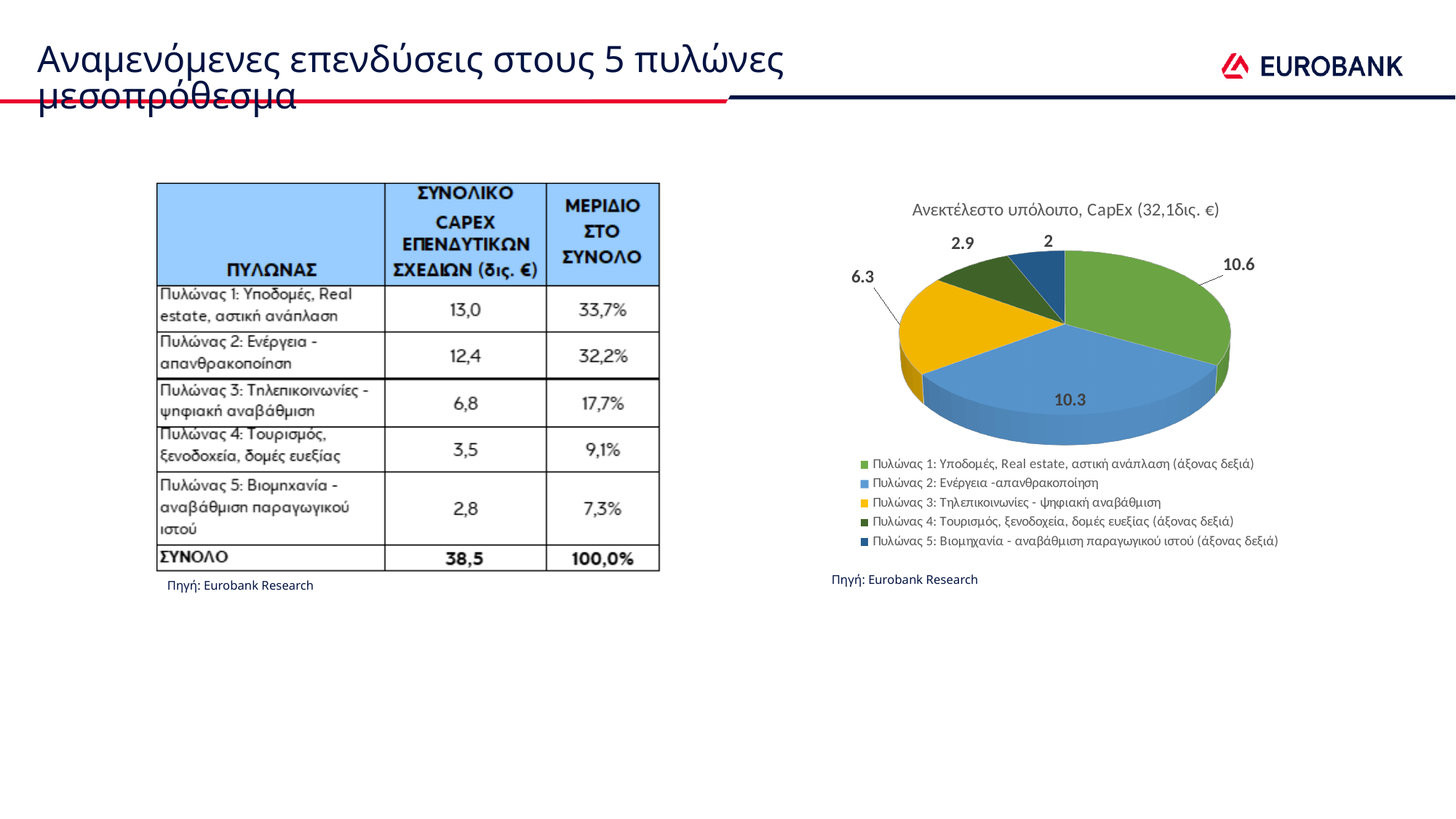
In the pie chart, what is the value for Πυλώνας 2: Ενέργεια - απανθρακοποίηση? 10.3 In the pie chart, which is larger: the value for Πυλώνας 3 or the value for Πυλώνας 4? Πυλώνας 3 How many slices does the pie chart have? 5 In the pie chart, what is the difference between the values for Πυλώνας 1 and Πυλώνας 2? 0.3 In the pie chart, what is the value for Πυλώνας 3: Τηλεπικοινωνίες - ψηφιακή αναβάθμιση? 6.3 How many entries does the legend of the pie chart list? 5 In the pie chart, what is the value for Πυλώνας 5: Βιομηχανία - αναβάθμιση παραγωγικού ιστού? 2 Which slice of the pie chart has the smallest value? Πυλώνας 5: Βιομηχανία - αναβάθμιση παραγωγικού ιστού What type of chart is shown on the right of the slide? Pie chart What is the title of the pie chart? Ανεκτέλεστο υπόλοιπο, CapEx (32,1δις. €) Which slice of the pie chart has the largest value? Πυλώνας 1: Υποδομές, Real estate, αστική ανάπλαση In the pie chart, what is the difference between the values for Πυλώνας 3 and Πυλώνας 4? 3.4